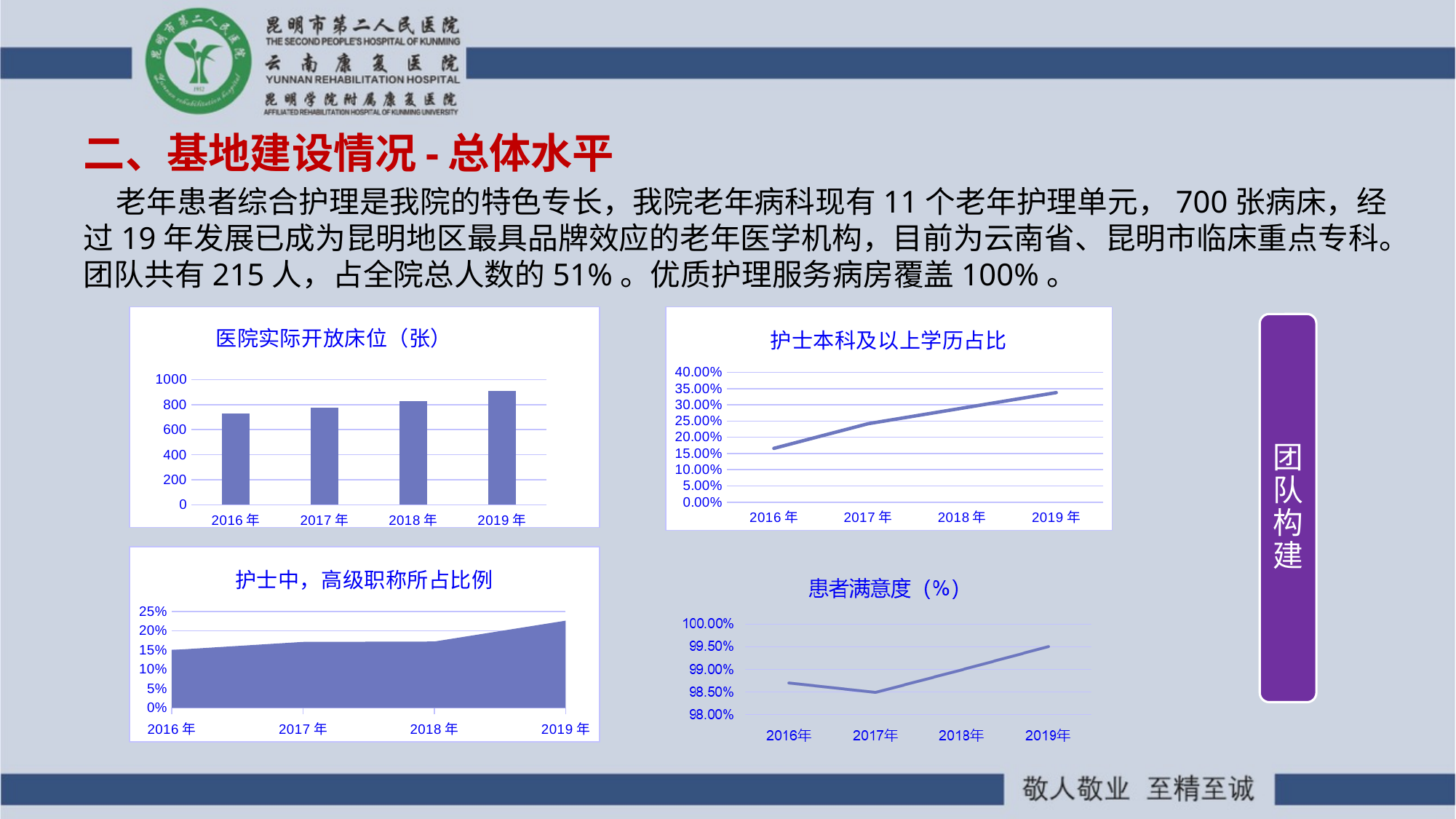
In the 护士本科及以上学历占比 chart, is the value for 2019年 greater or less than 30.00%? greater In the 医院实际开放床位（张） chart, how many years are shown on the x axis? 4 In the 医院实际开放床位（张） chart, is the value for 2016年 greater or less than 800? less In the 护士本科及以上学历占比 chart, do the values rise or fall from 2016年 to 2019年? rise In the 护士中，高级职称所占比例 chart, is the value for 2019年 greater or less than 20%? greater In the 医院实际开放床位（张） chart, which year has the lowest number of beds? 2016年 In the 患者满意度（%） chart, which year has the lowest satisfaction value? 2017年 What kind of chart is the 医院实际开放床位（张） chart? bar chart What kind of chart is the 护士本科及以上学历占比 chart? line chart In the 医院实际开放床位（张） chart, which year has the highest number of beds? 2019年